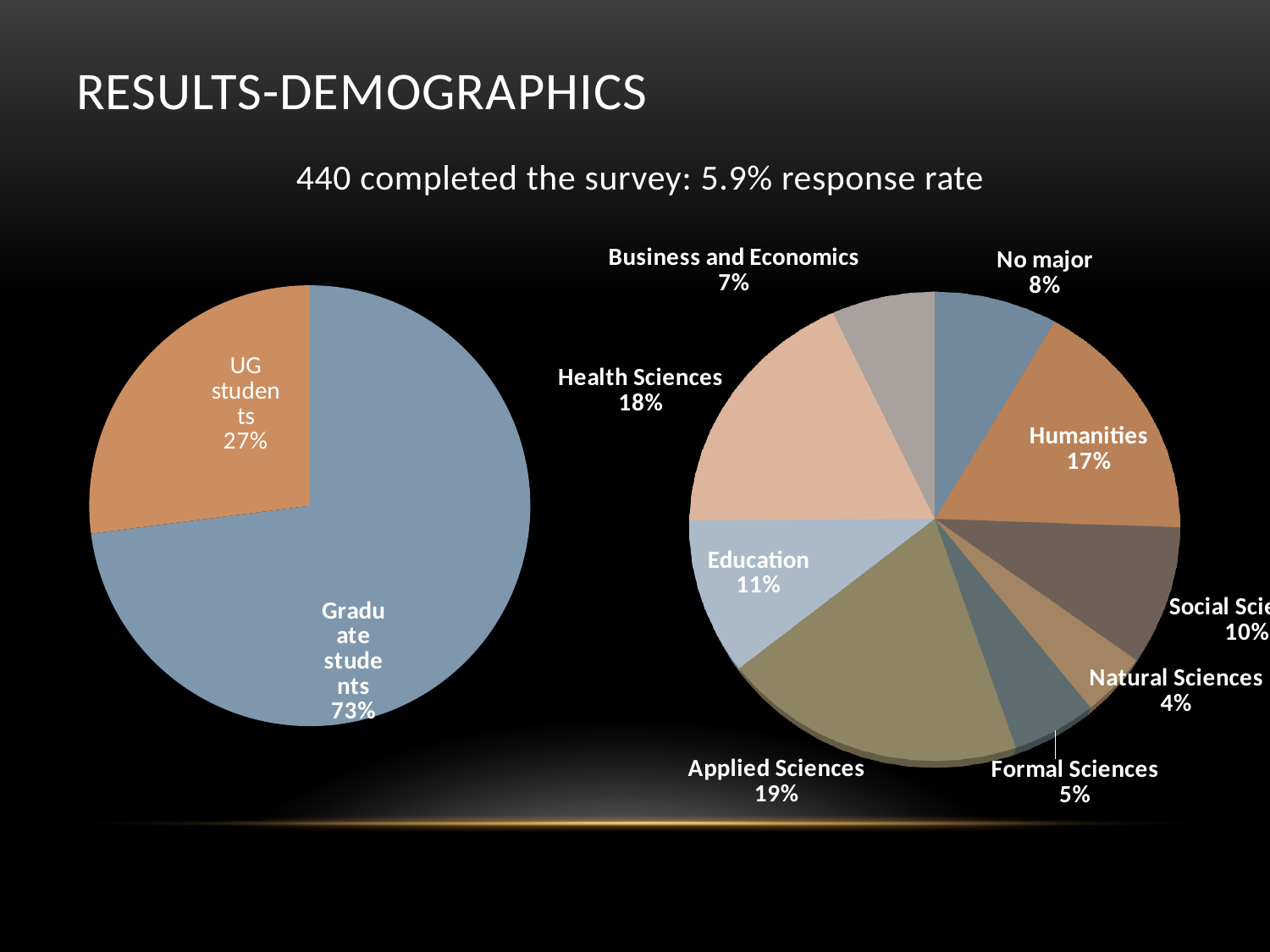
In the left pie chart, what share do UG students represent? 27% In the right pie chart, which category has the largest share? Applied Sciences What type of chart is the left chart on the slide? Pie chart In the right pie chart, what share is Health Sciences? 18% In the right pie chart, which category has the smallest share? Natural Sciences In the right pie chart, what share is Applied Sciences? 19% In the right pie chart, what is the difference between Health Sciences and Business and Economics? 11% In the right pie chart, what share is No major? 8% In the left pie chart, what is the difference between the Graduate students share and the UG students share? 46% How many slices does the right pie chart have? 9 In the left pie chart, what share do Graduate students represent? 73% In the right pie chart, which is larger: Humanities or Education? Humanities